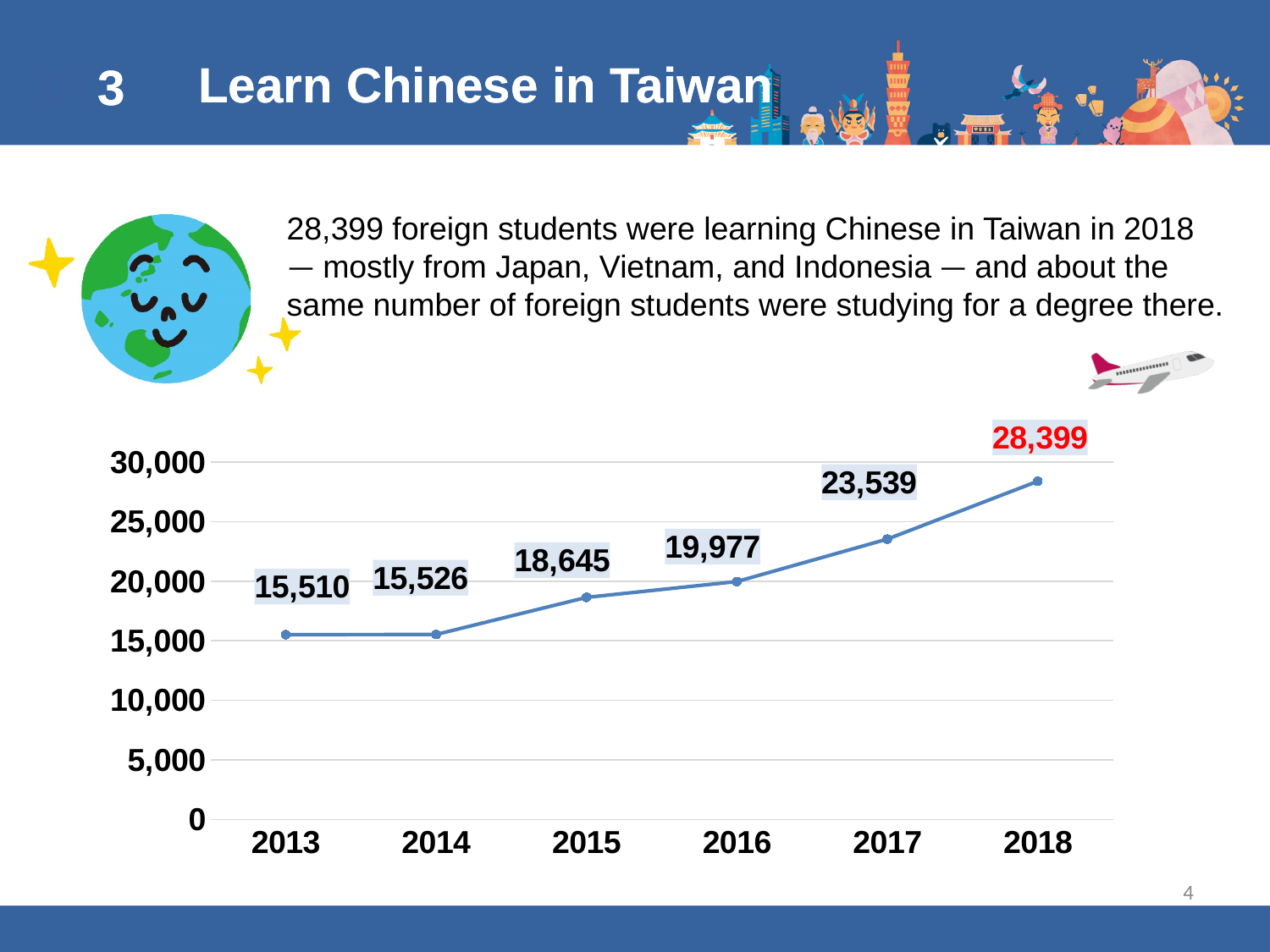
Which year has the highest value? 2018 Which is larger, the value for 2016 or the value for 2017? 2017 What is the difference between the values for 2018 and 2017? 4,860 What kind of chart is shown on the slide? line chart What value is shown for 2018? 28,399 Is the value for 2017 greater or less than 20,000? greater Do the values rise or fall from 2013 to 2018? rise What value is shown for 2013? 15,510 What is the difference between the values for 2016 and 2015? 1,332 Which year has the lowest value? 2013 What value is shown for 2015? 18,645 How many years are plotted on the chart? 6